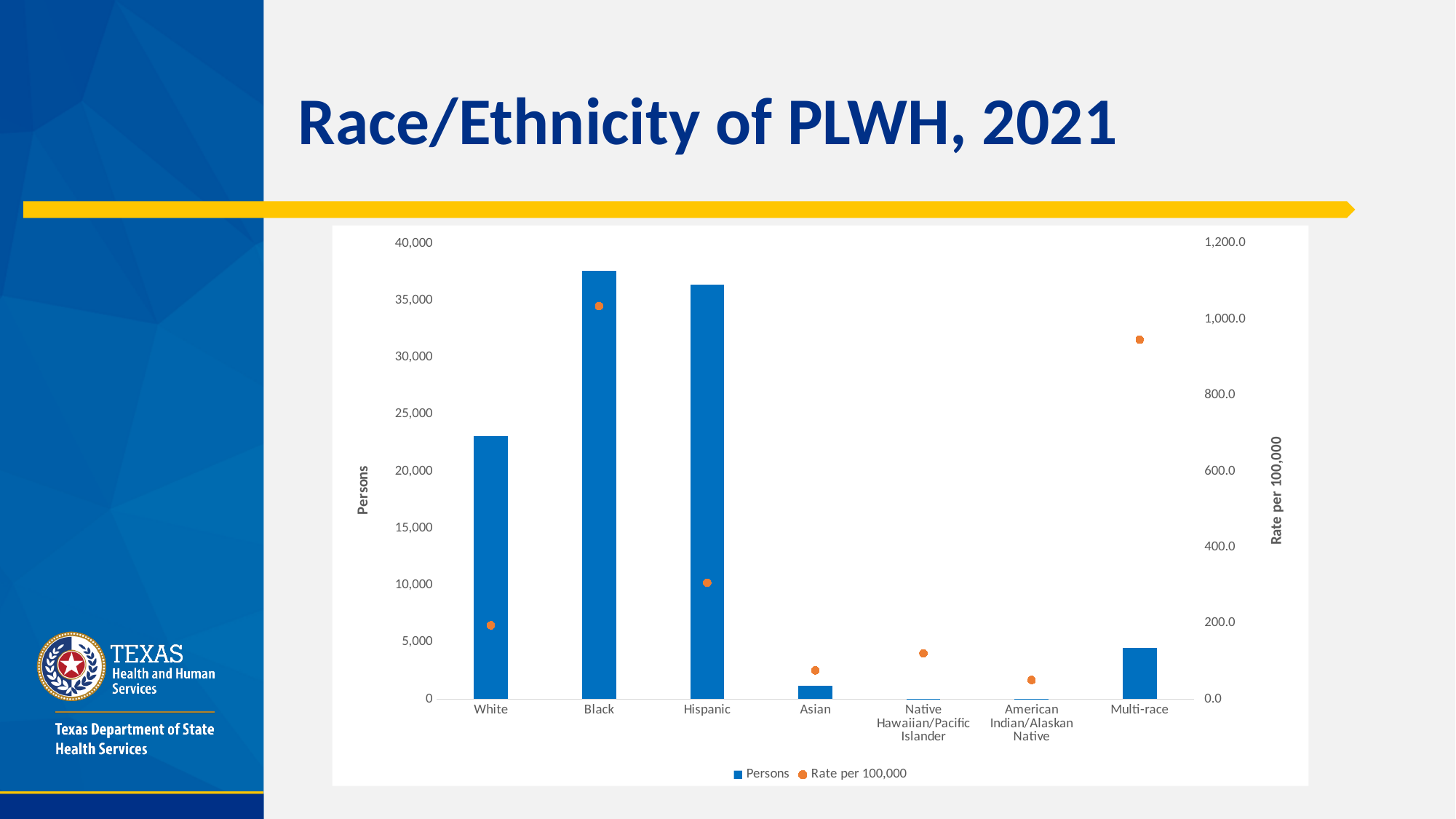
Is the rate per 100,000 for Multi-race greater or less than 800.0? greater How many series does the chart legend list? 2 Is the number of persons for Hispanic greater or less than 35,000? greater Which has more persons, White or Hispanic? Hispanic Is the number of persons for Multi-race greater or less than 5,000? less Which race/ethnicity category has the highest rate per 100,000? Black How many race/ethnicity categories are shown on the x axis of the chart? 7 What is the label of the left vertical axis of the chart? Persons Which race/ethnicity category has the lowest rate per 100,000? American Indian/Alaskan Native Which race/ethnicity category has the highest number of persons (tallest bar)? Black